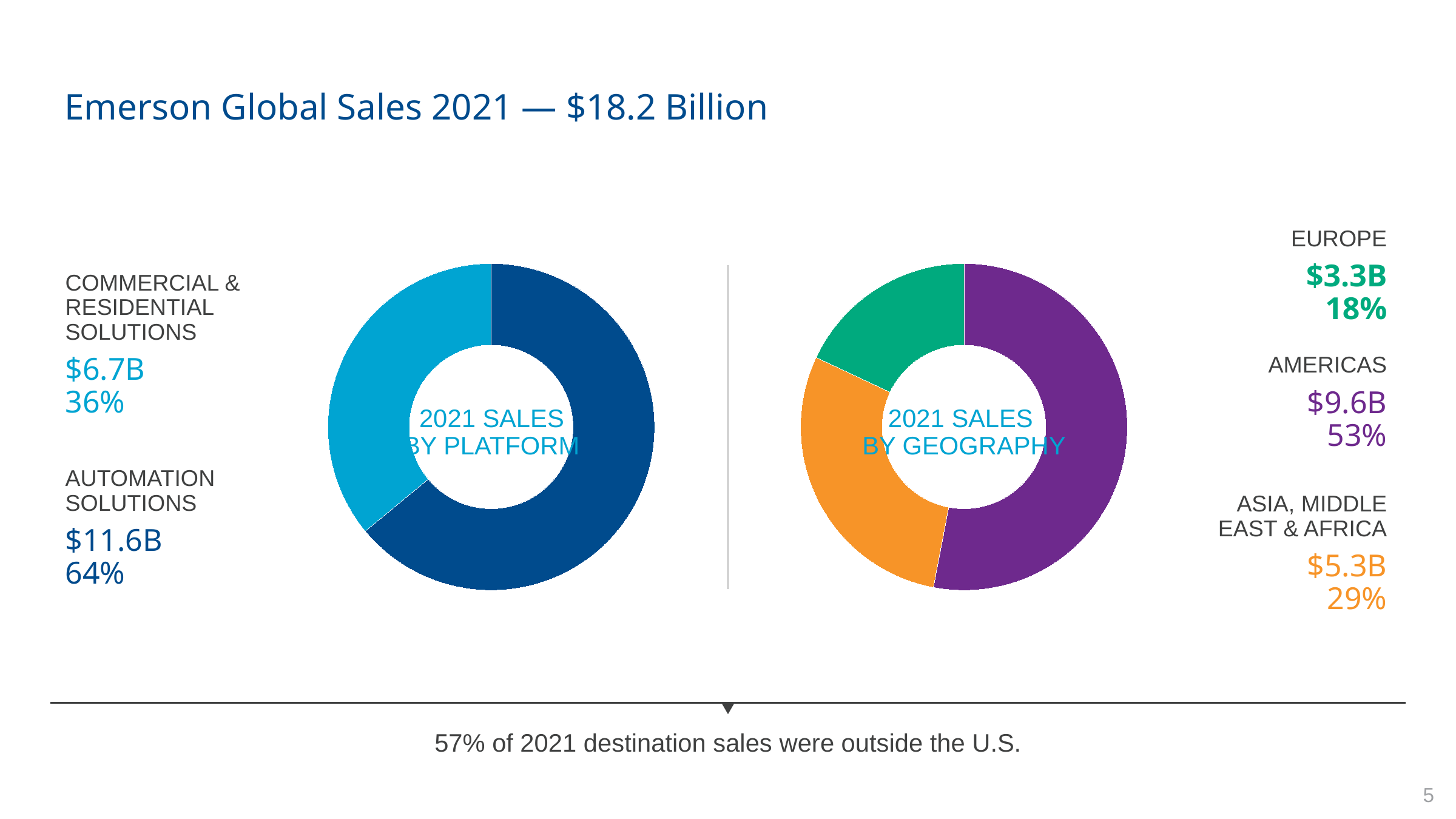
In the 2021 Sales by Geography chart, which region had the highest sales? Americas What kind of chart is the 2021 Sales by Geography chart? Doughnut (pie) chart In the 2021 Sales by Platform chart, how many platforms are shown? 2 In the 2021 Sales by Platform chart, what were the sales for Automation Solutions? $11.6B In the 2021 Sales by Platform chart, what share of sales came from Commercial & Residential Solutions? 36% In the 2021 Sales by Platform chart, what is the difference in sales between Automation Solutions and Commercial & Residential Solutions? $4.9B In the 2021 Sales by Geography chart, what is the difference in sales between the Americas and Asia, Middle East & Africa? $4.3B In the 2021 Sales by Platform chart, which platform had the larger sales? Automation Solutions In the 2021 Sales by Geography chart, which region had the lowest sales? Europe In the 2021 Sales by Geography chart, how many regions are shown? 3 In the 2021 Sales by Geography chart, what share of sales came from Europe? 18% In the 2021 Sales by Geography chart, what were the sales for the Americas? $9.6B